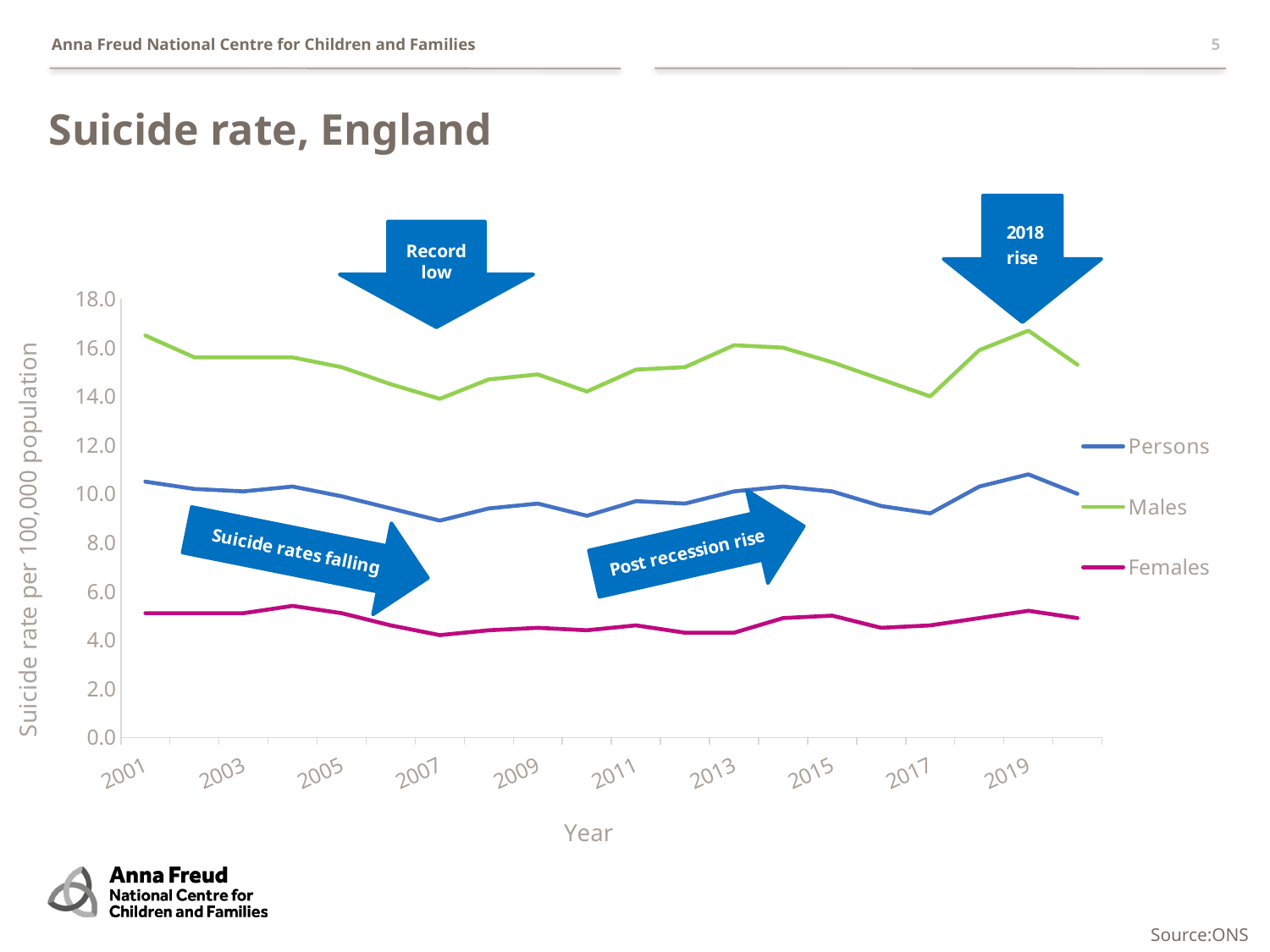
Which series has the highest suicide rate across all years? Males Which is larger in 2013, the value for Males or the value for Females? Males What is the title of the chart? Suicide rate, England Which series has the lowest suicide rate across all years? Females Is the value for Males in 2001 greater or less than 16.0? greater Is the value for Males in 2019 greater or less than 16.0? greater Does the Males line rise or fall between 2001 and 2007? Fall Is the value for Females in 2007 greater or less than 5.0? less What kind of chart is shown on the slide? Line chart Does the Persons line rise or fall between 2007 and 2013? Rise How many series does the legend list? 3